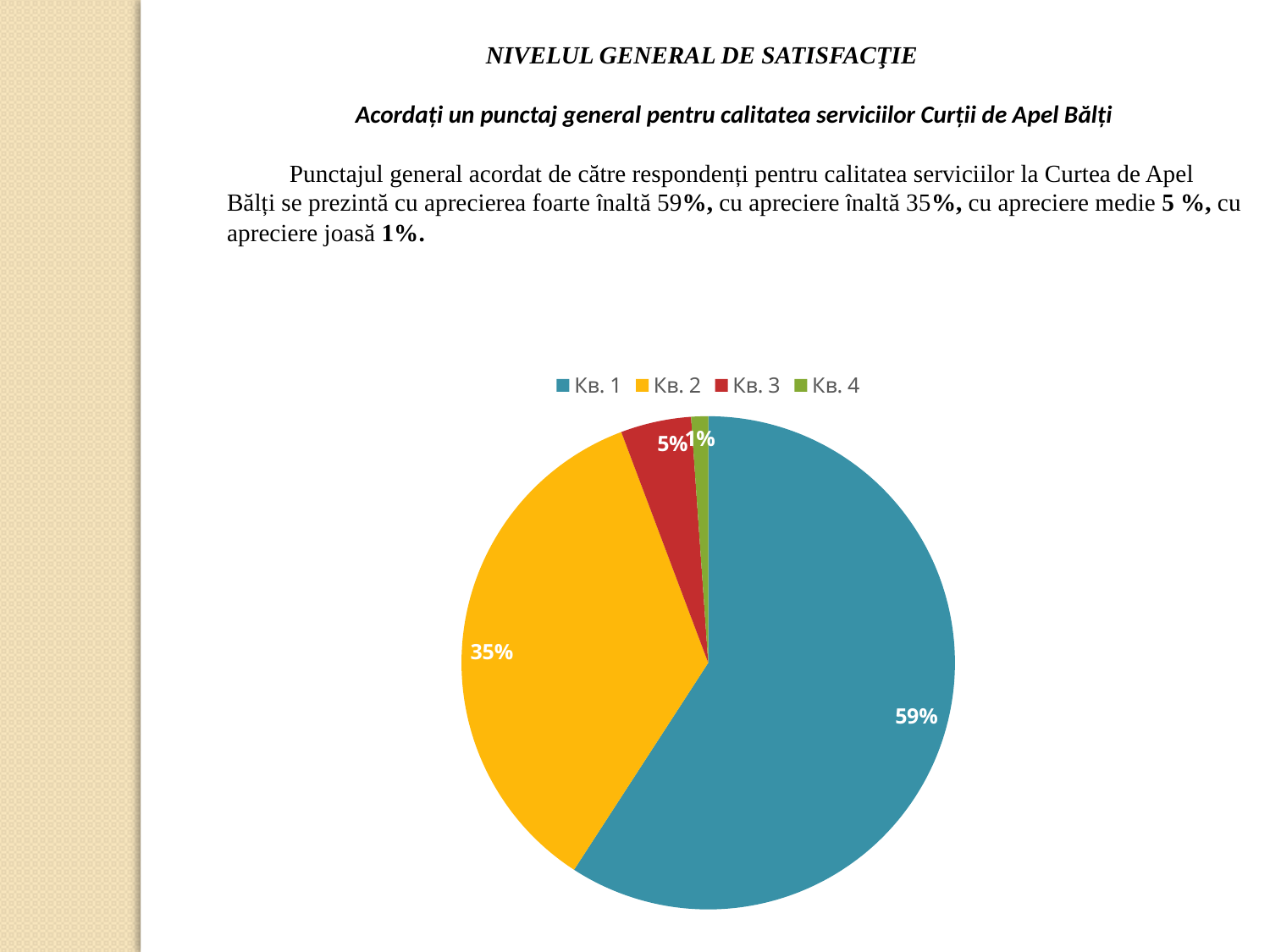
What is the value of the Кв. 3 slice? 5% Which slice is the smallest? Кв. 4 What colour is the Кв. 2 slice? yellow What is the value of the Кв. 1 slice? 59% Which is larger, the Кв. 2 slice or the Кв. 3 slice? Кв. 2 What kind of chart is shown on the slide? pie chart How many entries does the legend list? 4 How many slices does the pie chart have? 4 What is the value of the Кв. 2 slice? 35% What is the value of the Кв. 4 slice? 1% What is the difference between the Кв. 1 and Кв. 2 slices? 24% Which slice is the largest? Кв. 1